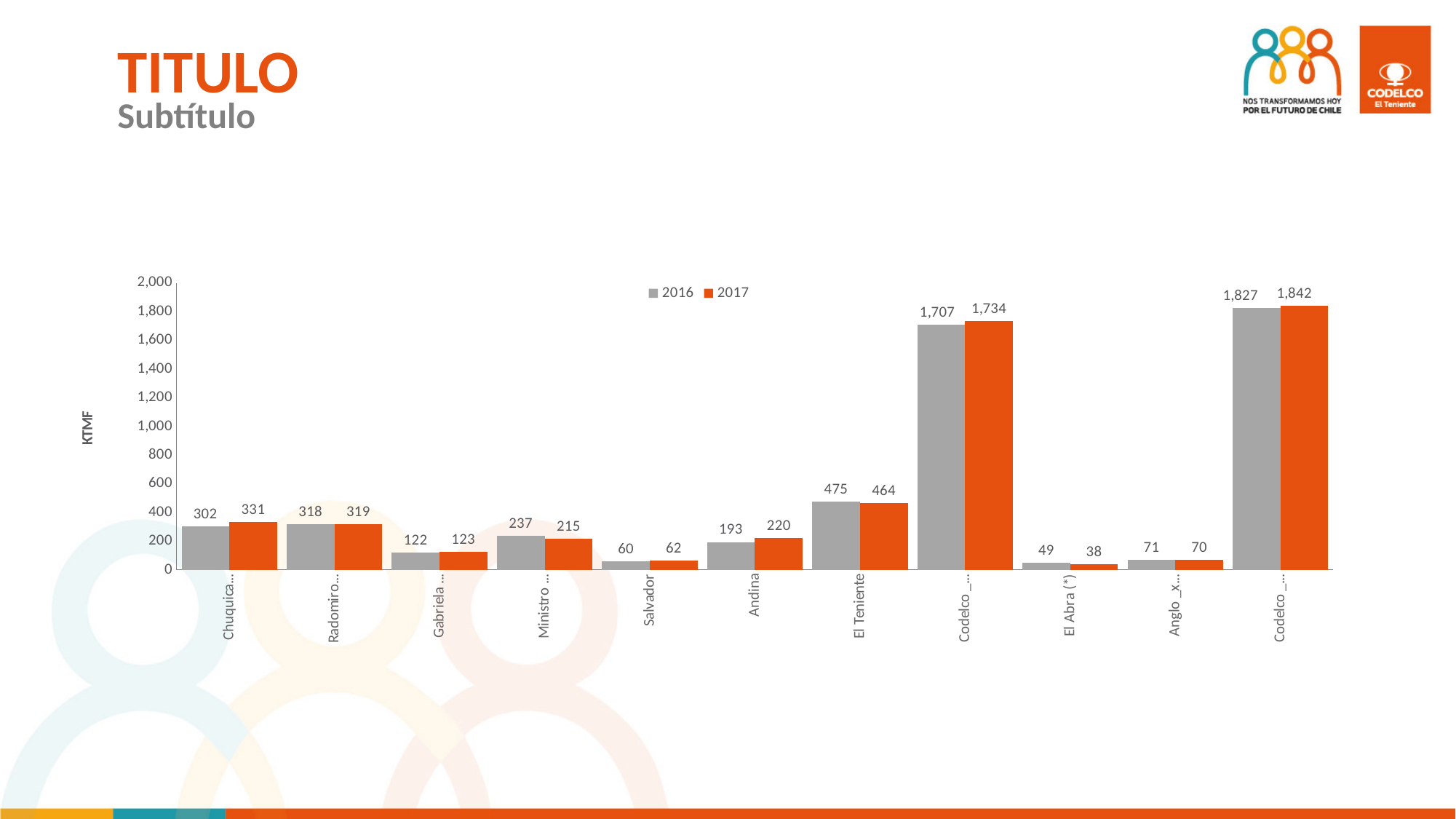
How many categories are shown on the x axis? 11 What kind of chart is shown on the slide? bar chart What is the highest 2017 value shown on the chart? 1,842 What is the 2017 value for El Abra (*)? 38 What is the 2016 value for Salvador? 60 What is the label on the vertical axis? KTMF How many series does the legend list? 2 What is the 2017 value for Andina? 220 What is the 2016 value for El Teniente? 475 Which category has the lowest 2017 value? El Abra (*) What is the difference between the 2016 and 2017 values for El Teniente? 11 For Andina, which year has the larger value, 2016 or 2017? 2017